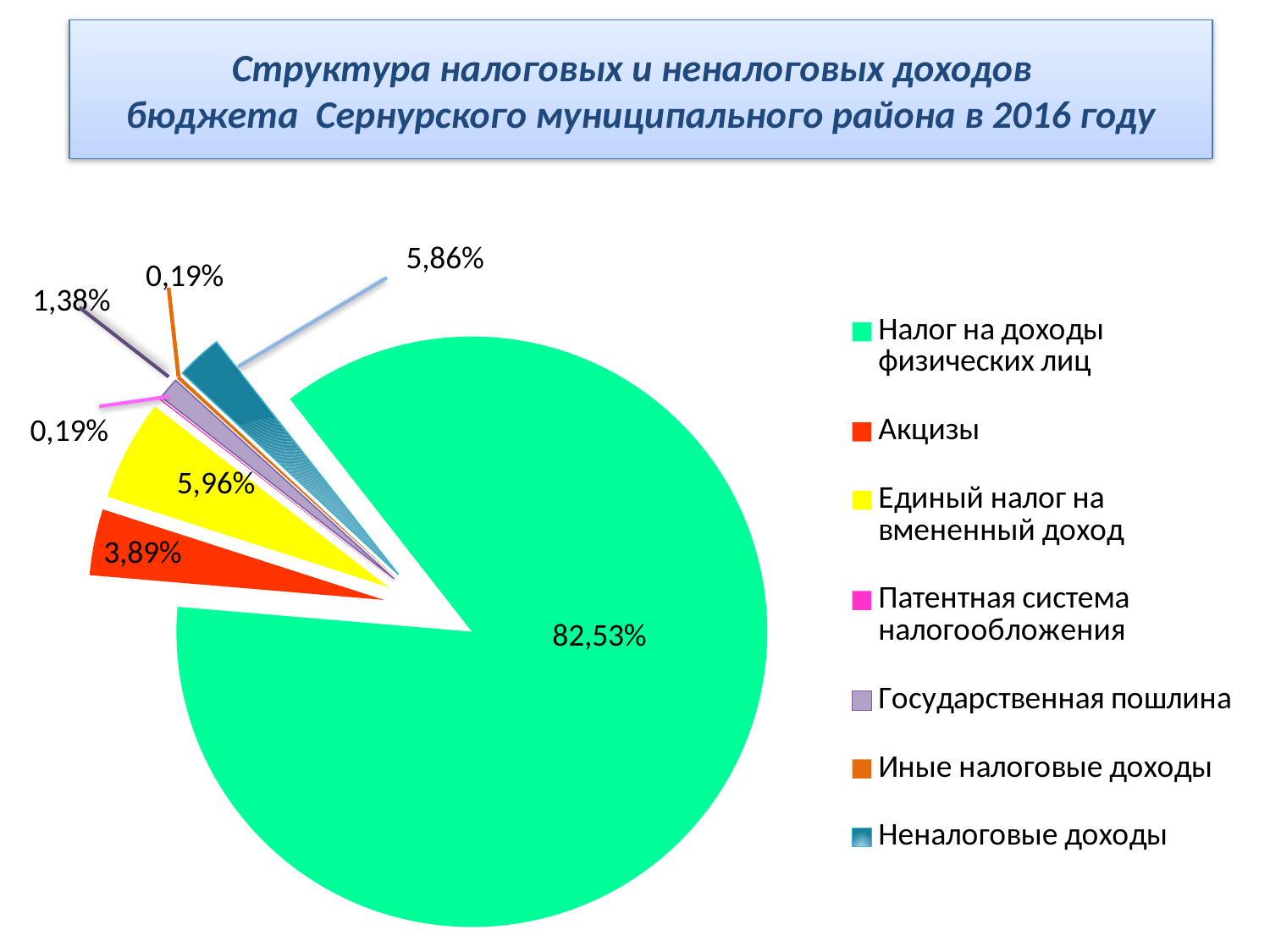
What is the difference between the shares of "Неналоговые доходы" and "Государственная пошлина"? 4,48% How many categories does the legend list? 7 Which colour represents "Акцизы" in the pie chart? Red Which is larger: "Единый налог на вмененный доход" or "Неналоговые доходы"? Единый налог на вмененный доход What share of the pie does "Налог на доходы физических лиц" have? 82,53% Which category has the largest share of the pie? Налог на доходы физических лиц What is the value shown for "Неналоговые доходы"? 5,86% What is the value shown for "Государственная пошлина"? 1,38% What type of chart is shown on the slide? Pie chart What is the value shown for "Акцизы"? 3,89% What is the value shown for "Единый налог на вмененный доход"? 5,96% What is the difference between the shares of "Единый налог на вмененный доход" and "Акцизы"? 2,07%